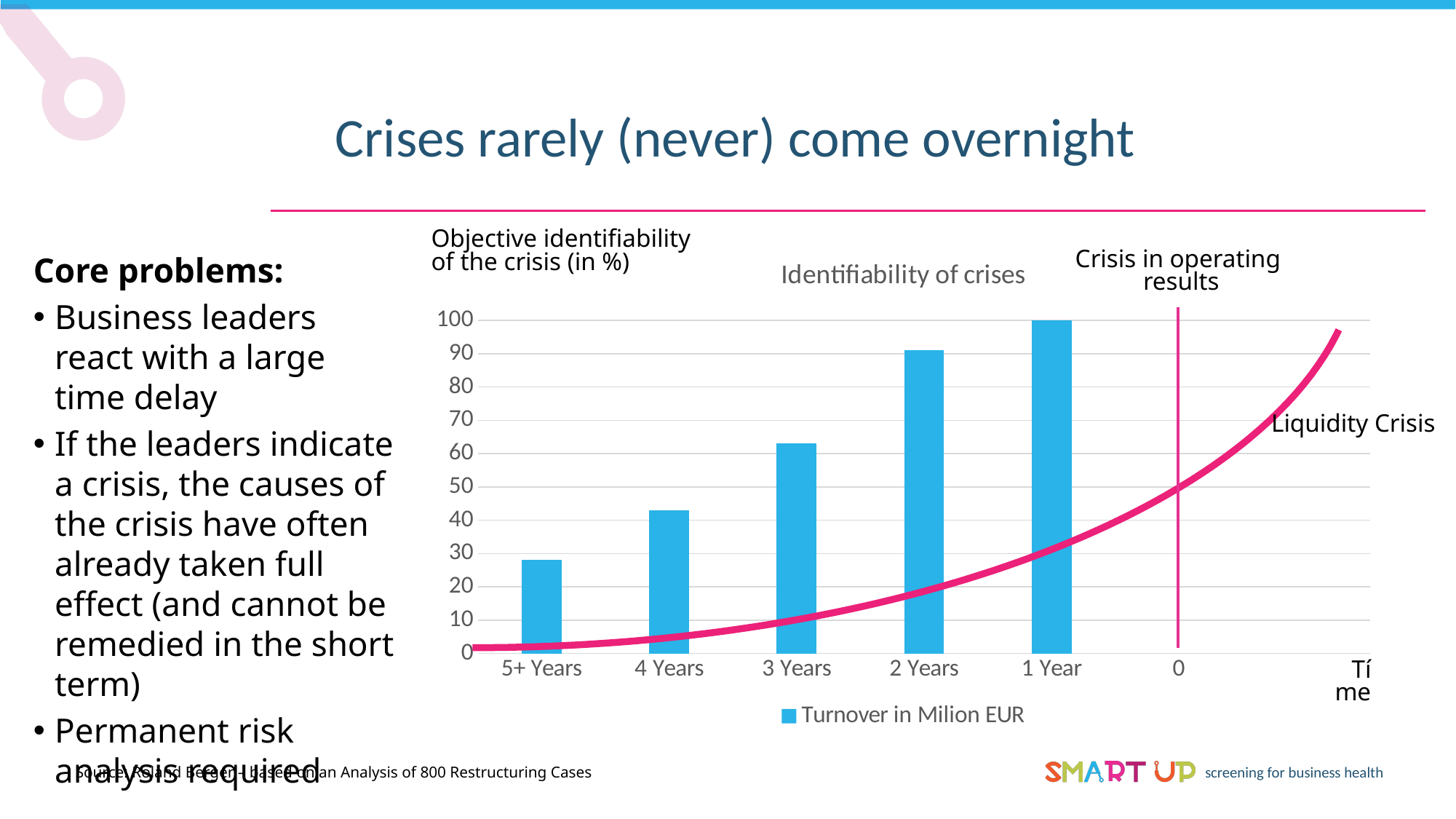
How many entries does the legend list? 1 Is the value for 5+ Years greater or less than 30? less Which category has the shortest bar? 5+ Years Do the bar values rise or fall from 5+ Years to 1 Year? rise What is the title of the chart? Identifiability of crises Is the value for 4 Years greater or less than 50? less Which category has the tallest bar? 1 Year Is the value for 3 Years greater or less than 60? greater Which bar is taller, 2 Years or 3 Years? 2 Years What kind of chart is shown on the slide? bar chart What value does the bar for 1 Year reach on the axis? 100